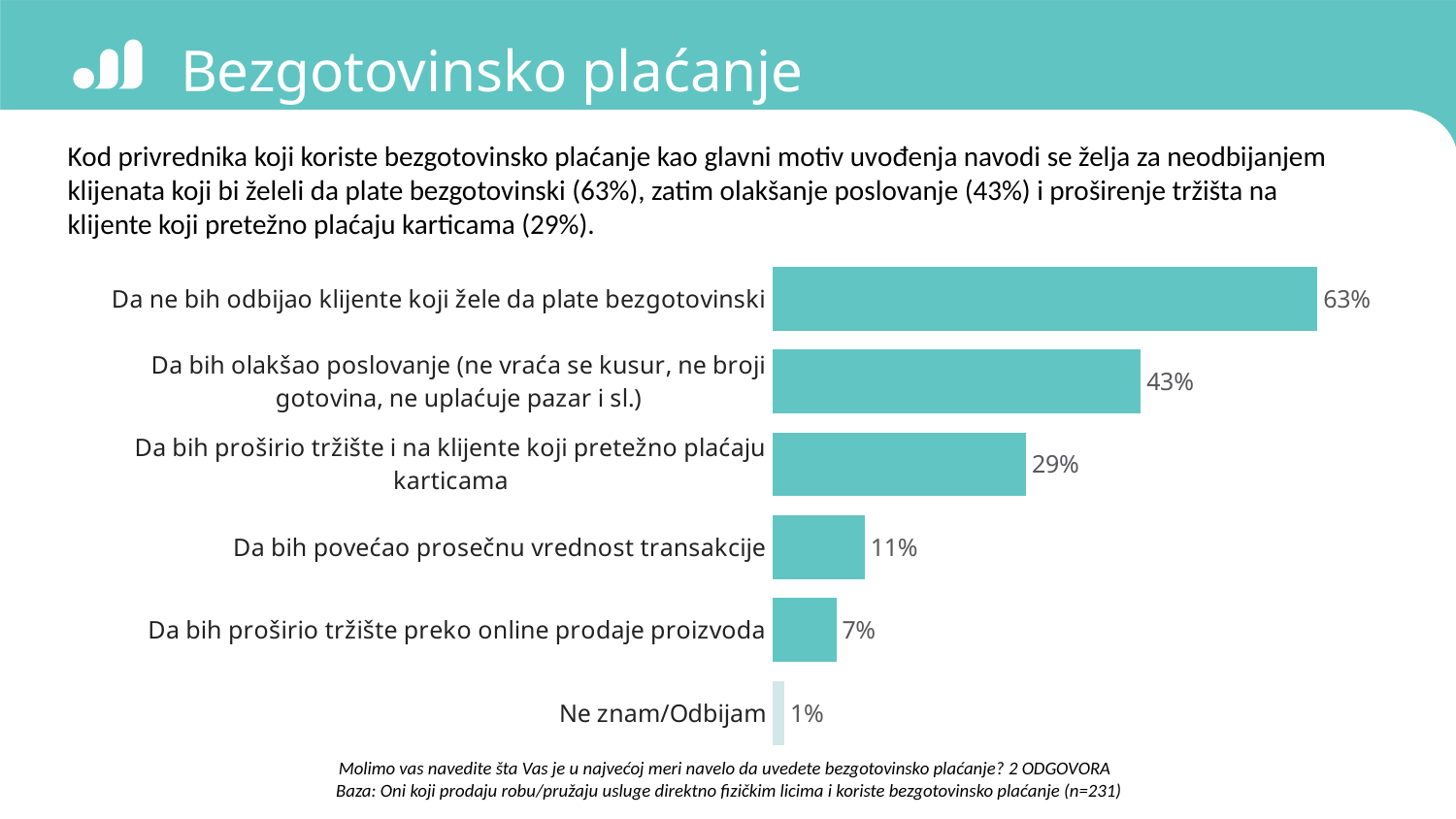
What is the title of the slide? Bezgotovinsko plaćanje What is the value for "Ne znam/Odbijam"? 1% What is the value for "Da ne bih odbijao klijente koji žele da plate bezgotovinski"? 63% What is the value for "Da bih povećao prosečnu vrednost transakcije"? 11% What is the difference between the values for "Da ne bih odbijao klijente koji žele da plate bezgotovinski" and "Da bih olakšao poslovanje (ne vraća se kusur, ne broji gotovina, ne uplaćuje pazar i sl.)"? 20% Which category has the highest value? Da ne bih odbijao klijente koji žele da plate bezgotovinski What is the difference between the values for "Da bih proširio tržište i na klijente koji pretežno plaćaju karticama" and "Da bih povećao prosečnu vrednost transakcije"? 18% Which is larger: the value for "Da bih olakšao poslovanje (ne vraća se kusur, ne broji gotovina, ne uplaćuje pazar i sl.)" or for "Da bih proširio tržište i na klijente koji pretežno plaćaju karticama"? Da bih olakšao poslovanje (ne vraća se kusur, ne broji gotovina, ne uplaćuje pazar i sl.) What is the value for "Da bih proširio tržište preko online prodaje proizvoda"? 7% How many categories are shown in the chart? 6 Which category has the lowest value? Ne znam/Odbijam What kind of chart is shown on the slide? Bar chart